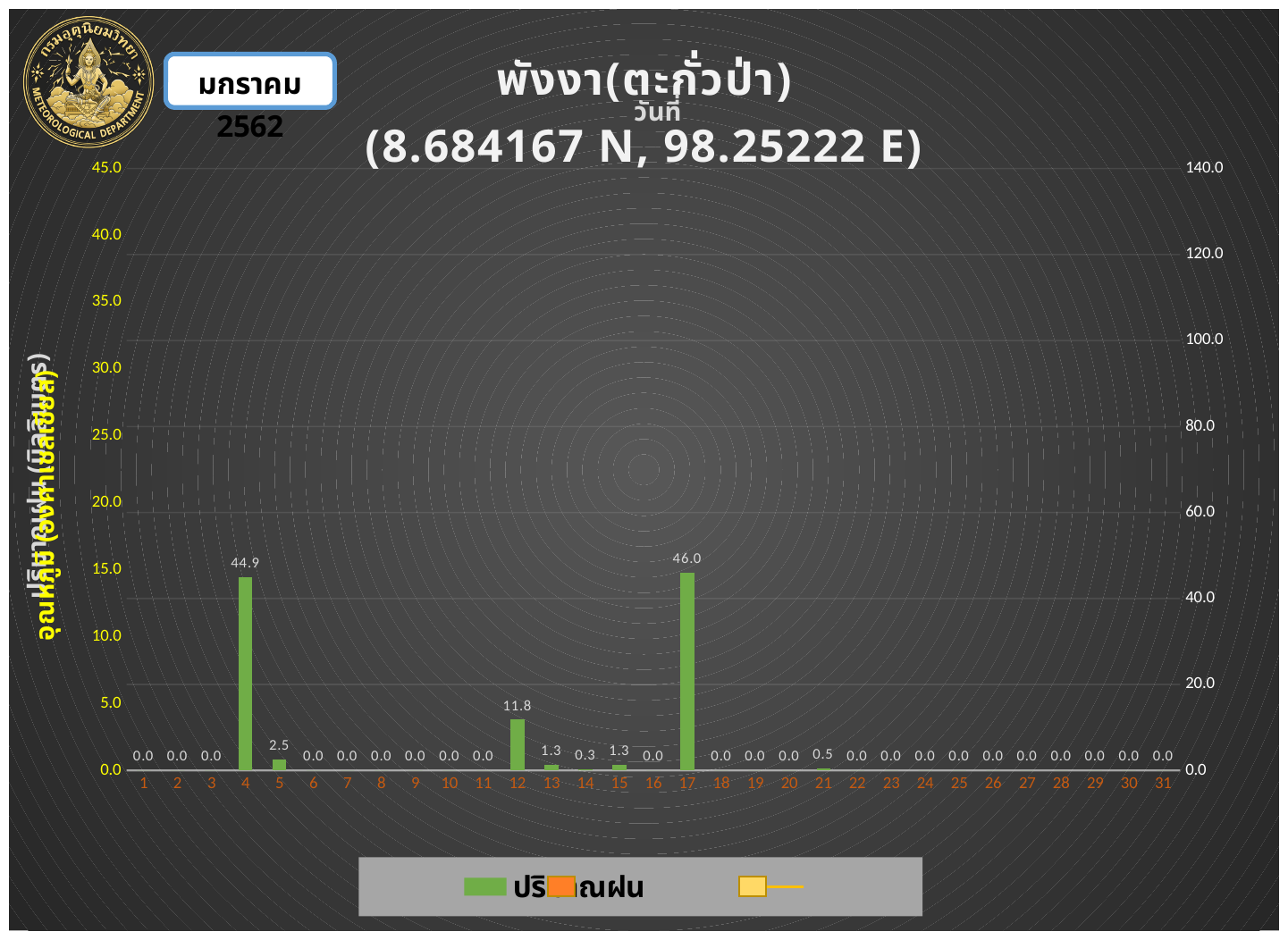
What is the rainfall value labelled for day 21? 0.5 What are the coordinates shown in the chart title? 8.684167 N, 98.25222 E What is the rainfall value labelled for day 17? 46.0 How many days are shown on the x axis? 31 What is the difference between the rainfall values for day 17 and day 4? 1.1 What kind of chart is shown on the slide? bar chart What is the rainfall value labelled for day 12? 11.8 What is the rainfall value labelled for day 5? 2.5 Which day has the highest rainfall value? 17 What is the difference between the rainfall values for day 12 and day 5? 9.3 Which is larger, the rainfall value for day 13 or for day 14? day 13 What is the rainfall value labelled for day 4? 44.9